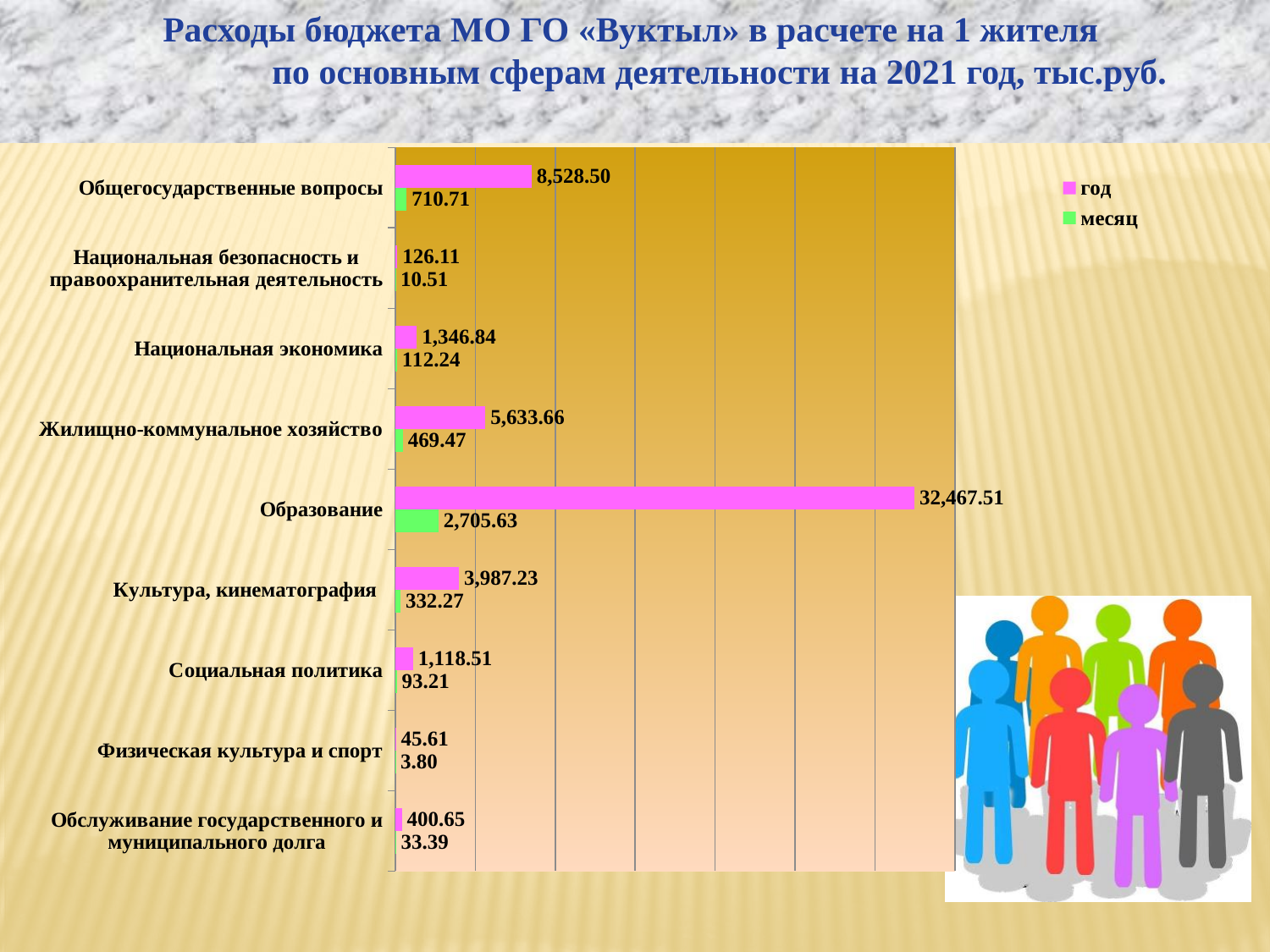
What kind of chart is shown on the slide? Bar chart Which has the larger "год" value: Национальная экономика or Социальная политика? Национальная экономика What is the value of the "год" series for Образование? 32,467.51 How many categories are shown on the chart? 9 Which category has the lowest "год" value? Физическая культура и спорт What is the "месяц" value for Жилищно-коммунальное хозяйство? 469.47 What is the "год" value for Общегосударственные вопросы? 8,528.50 What is the value of the "месяц" series for Образование? 2,705.63 Which category has the highest "год" value? Образование How many series does the legend list? 2 What is the difference between the "год" values for Общегосударственные вопросы and Жилищно-коммунальное хозяйство? 2,894.84 What is the "год" value for Физическая культура и спорт? 45.61